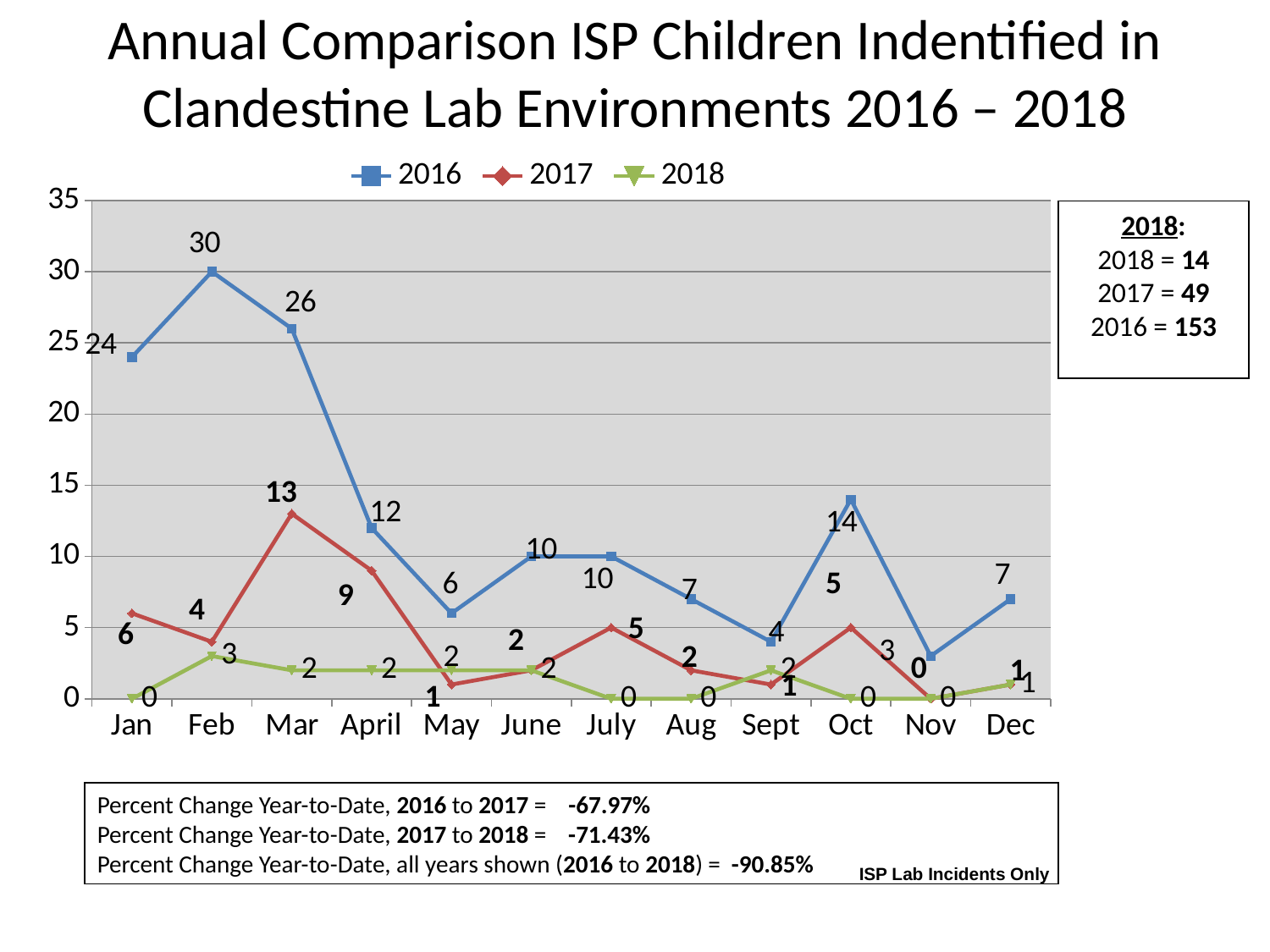
What is the 2016 value for Feb? 30 Which is larger, the 2016 value for Oct or the 2016 value for Sept? Oct In which month does the 2016 series reach its highest value? Feb What is the 2016 year-to-date total shown in the box on the right? 153 How many series does the legend list? 3 In which month does the 2017 series reach its highest value? Mar What is the 2018 value for Feb? 3 Does the 2016 series rise or fall from Feb to May? Fall What is the 2017 value for Mar? 13 What is the difference between the 2016 and 2017 values for Jan? 18 How many months are shown on the x axis? 12 What kind of chart is shown on the slide? Line chart